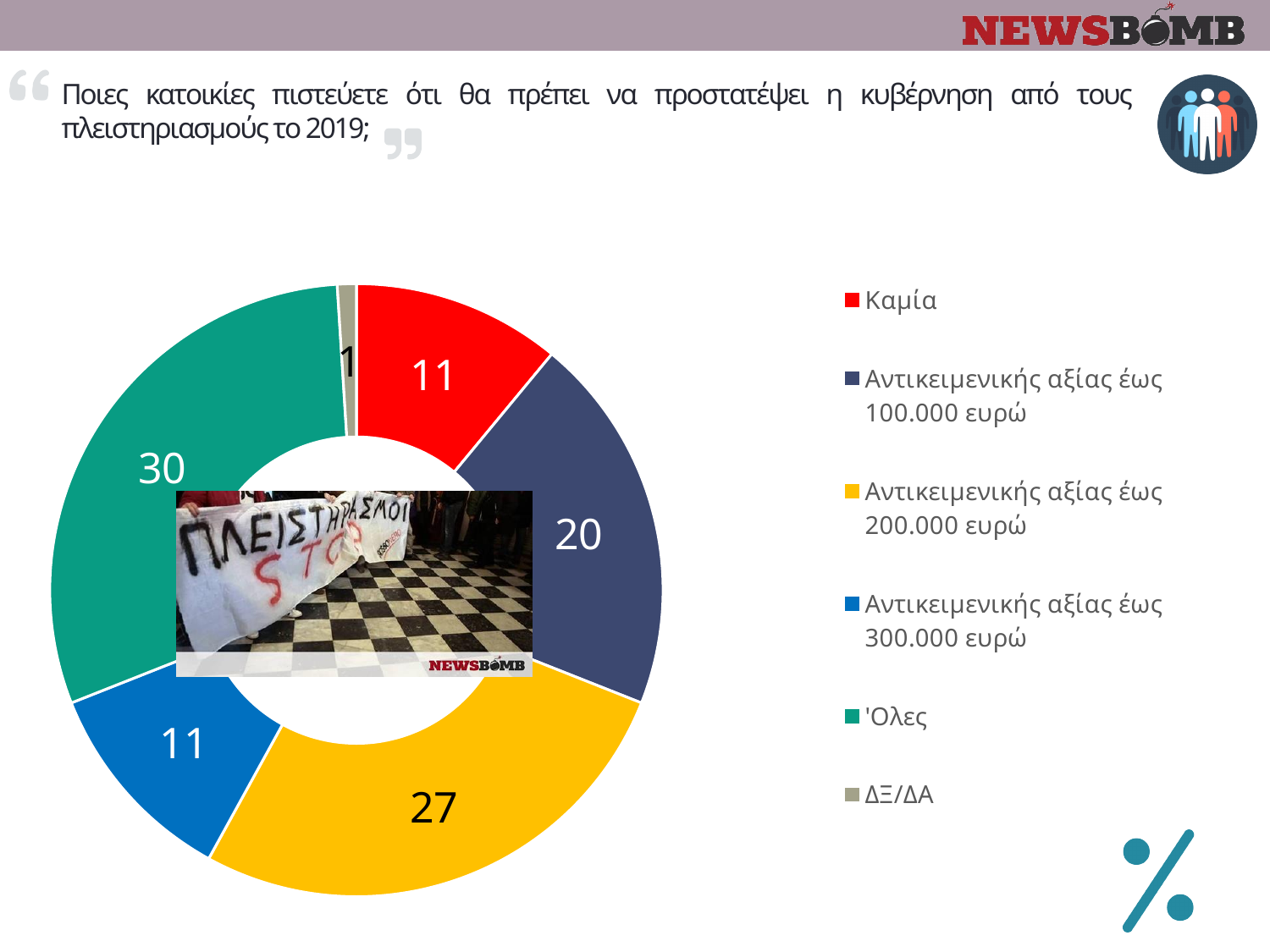
What is the value for 'Αντικειμενικής αξίας έως 100.000 ευρώ'? 20 What kind of chart is shown on the slide? Doughnut chart How many categories does the legend list? 6 What colour is the slice for 'Καμία'? Red Which is larger: the value for 'Αντικειμενικής αξίας έως 100.000 ευρώ' or for 'Αντικειμενικής αξίας έως 300.000 ευρώ'? Αντικειμενικής αξίας έως 100.000 ευρώ What is the value for 'Όλες'? 30 What is the difference between the values for 'Όλες' and 'Αντικειμενικής αξίας έως 200.000 ευρώ'? 3 What is the value for 'Αντικειμενικής αξίας έως 200.000 ευρώ'? 27 Which category has the largest slice? Όλες What is the value for 'Καμία'? 11 What is the value for 'ΔΞ/ΔΑ'? 1 Which category has the smallest slice? ΔΞ/ΔΑ